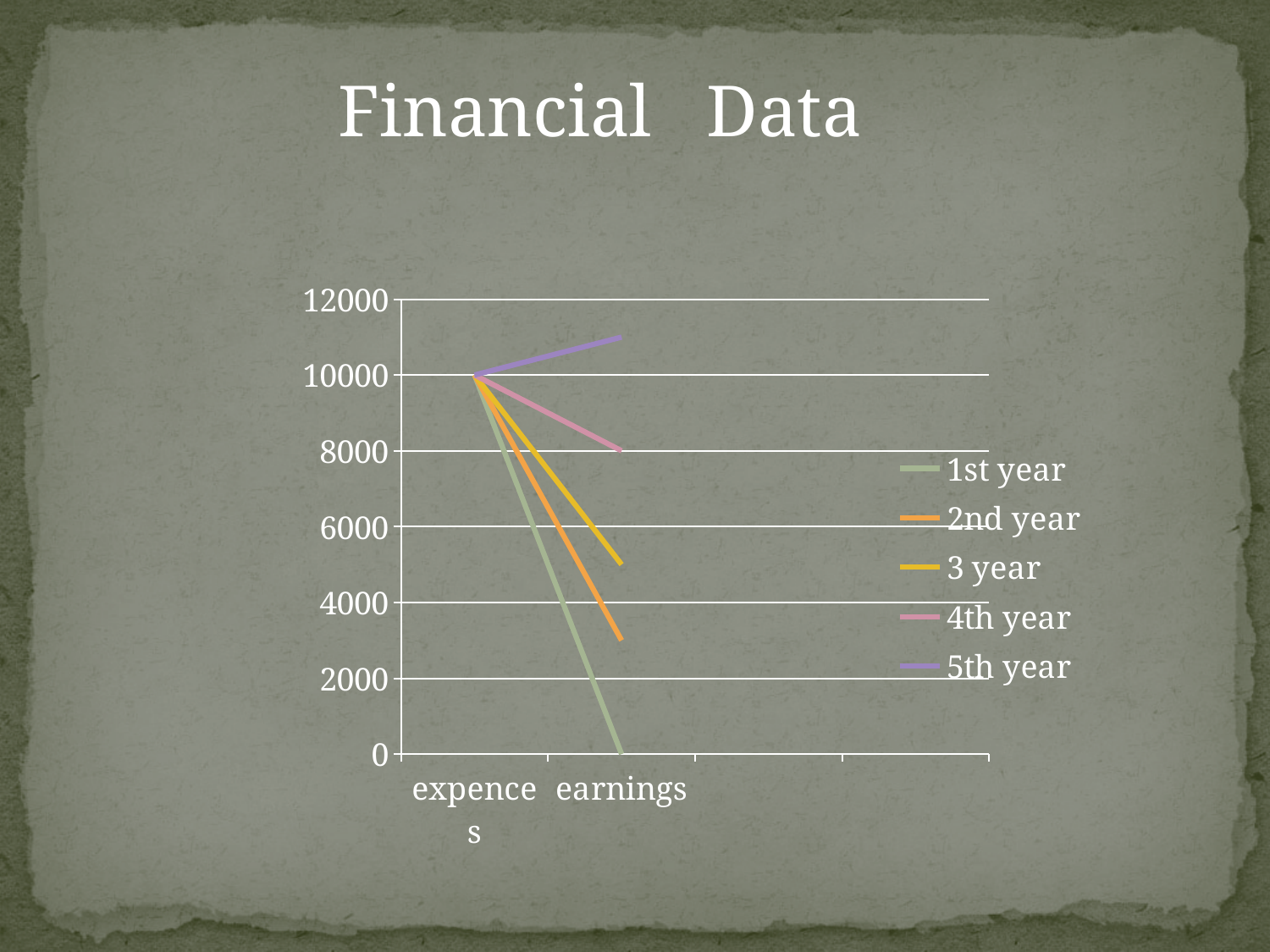
What is the earnings value for 1st year? 0 Which has the larger earnings value, 4th year or 2nd year? 4th year What kind of chart is shown on the slide? line chart What is the earnings value for 4th year? 8000 How many series does the legend list? 5 Is the earnings value for 5th year greater or less than 10000? greater Is the earnings value for 2nd year greater or less than 4000? less Does the 1st year line rise or fall from expences to earnings? fall Which series has the lowest earnings value? 1st year Which series has the highest earnings value? 5th year What is the expences value for 1st year? 10000 How many categories are shown on the x axis? 2